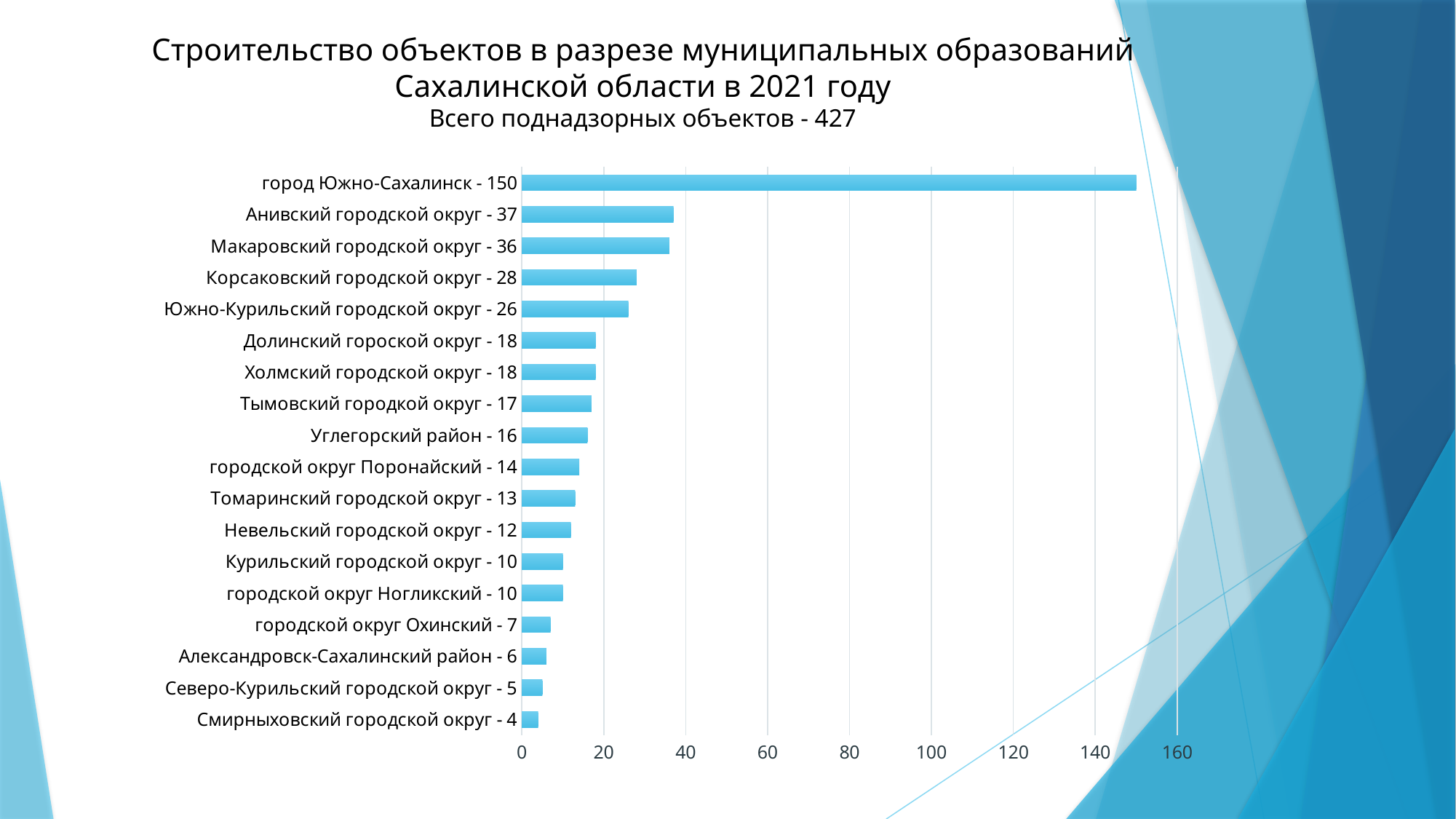
How many municipalities (categories) are plotted in the chart? 18 Which is larger, the value for Макаровский городской округ or Корсаковский городской округ? Макаровский городской округ What is the value for городской округ Охинский? 7 What is the difference between the values for город Южно-Сахалинск and Анивский городской округ? 113 Which municipality has the lowest number of objects? Смирныховский городской округ Which municipality has the highest number of objects? город Южно-Сахалинск What type of chart is shown on the slide? bar chart What is the value for Анивский городской округ? 37 What is the difference between the values for Южно-Курильский городской округ and Углегорский район? 10 Is the value for город Южно-Сахалинск greater or less than 140? greater What total number of supervised objects is stated in the chart title? 427 What is the value for Корсаковский городской округ? 28